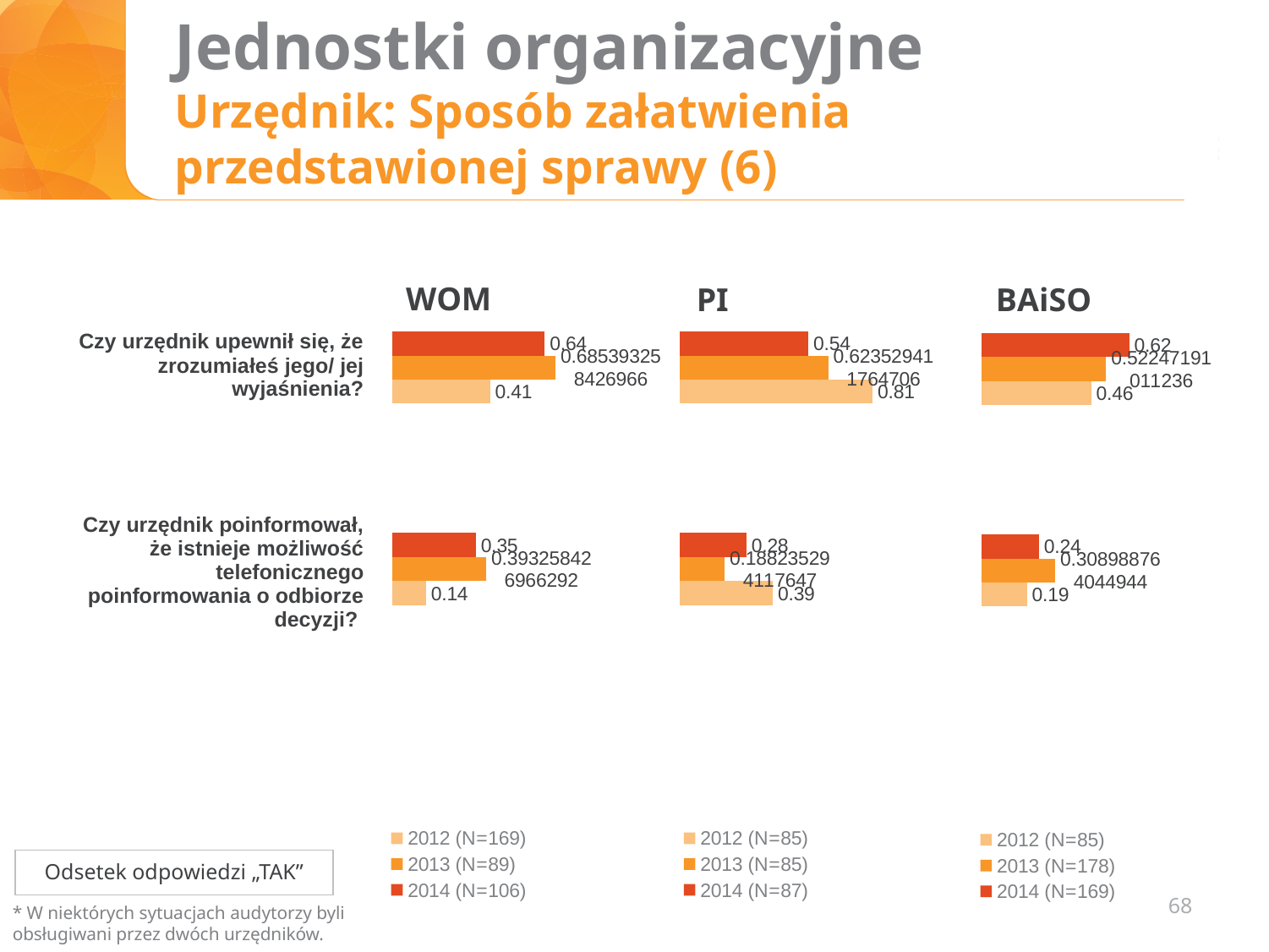
In the BAiSO chart for the question "Czy urzędnik upewnił się, że zrozumiałeś jego/ jej wyjaśnienia?", which year has the highest value? 2014 (N=169) In the PI chart for the question "Czy urzędnik poinformował, że istnieje możliwość telefonicznego poinformowania o odbiorze decyzji?", which year has the highest value? 2012 (N=85) In the WOM chart for the question "Czy urzędnik upewnił się, że zrozumiałeś jego/ jej wyjaśnienia?", what is the value for 2014 (N=106)? 0.64 How many series does the legend list for the WOM charts? 3 In the WOM chart for the question "Czy urzędnik poinformował, że istnieje możliwość telefonicznego poinformowania o odbiorze decyzji?", which year has the lowest value? 2012 (N=169) In the BAiSO chart for the question "Czy urzędnik poinformował, że istnieje możliwość telefonicznego poinformowania o odbiorze decyzji?", what is the value for 2014 (N=169)? 0.24 In the WOM chart for the question "Czy urzędnik upewnił się, że zrozumiałeś jego/ jej wyjaśnienia?", what is the difference between the 2014 value and the 2012 value? 0.23 In the PI chart for the question "Czy urzędnik upewnił się, że zrozumiałeś jego/ jej wyjaśnienia?", which is larger: the value for 2012 or the value for 2014? 2012 What is the sample size (N) shown in the legend for 2013 in the BAiSO charts? N=178 In the PI chart for the question "Czy urzędnik upewnił się, że zrozumiałeś jego/ jej wyjaśnienia?", what is the value for 2012 (N=85)? 0.81 What kind of chart is used for the PI data on this slide? Bar chart In the WOM chart for the question "Czy urzędnik upewnił się, że zrozumiałeś jego/ jej wyjaśnienia?", what is the value for 2012 (N=169)? 0.41